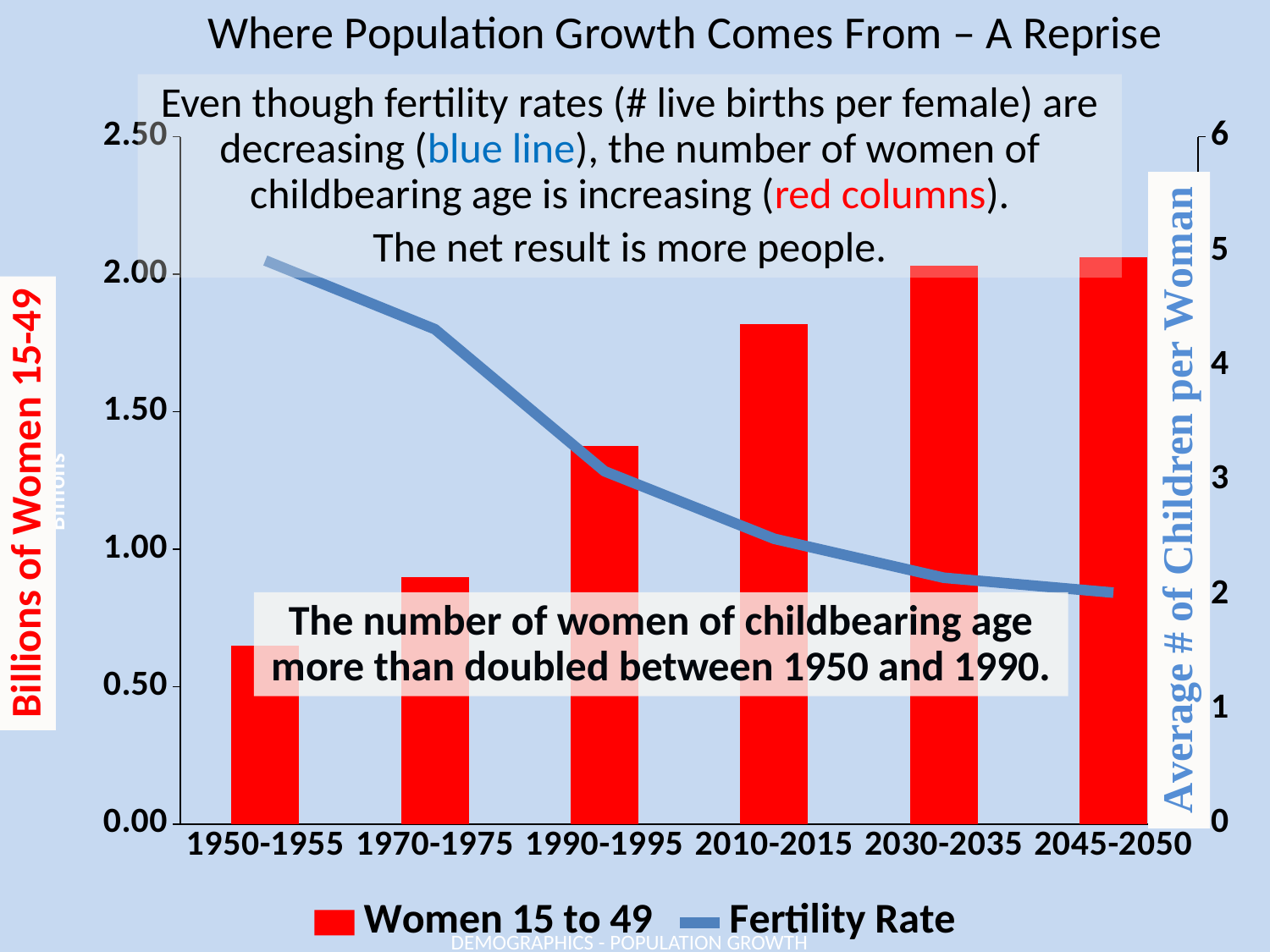
Is the value for Women 15 to 49 in 2010-2015 greater or less than 1.50? greater Is the value for Women 15 to 49 in 1950-1955 greater or less than 1.00? less Does the Fertility Rate line rise or fall across the periods shown? fall Which is larger, the Women 15 to 49 value for 1950-1955 or for 2010-2015? 2010-2015 Is the Fertility Rate in 2045-2050 greater or less than 3? less Do the Women 15 to 49 values rise or fall from 1950-1955 to 2045-2050? rise Which period has the lowest value for Women 15 to 49? 1950-1955 How many time periods are shown on the x axis? 6 How many series does the legend list? 2 What kind of chart is shown on the slide? A combined bar and line chart What is the title of the right-hand vertical axis? Average # of Children per Woman